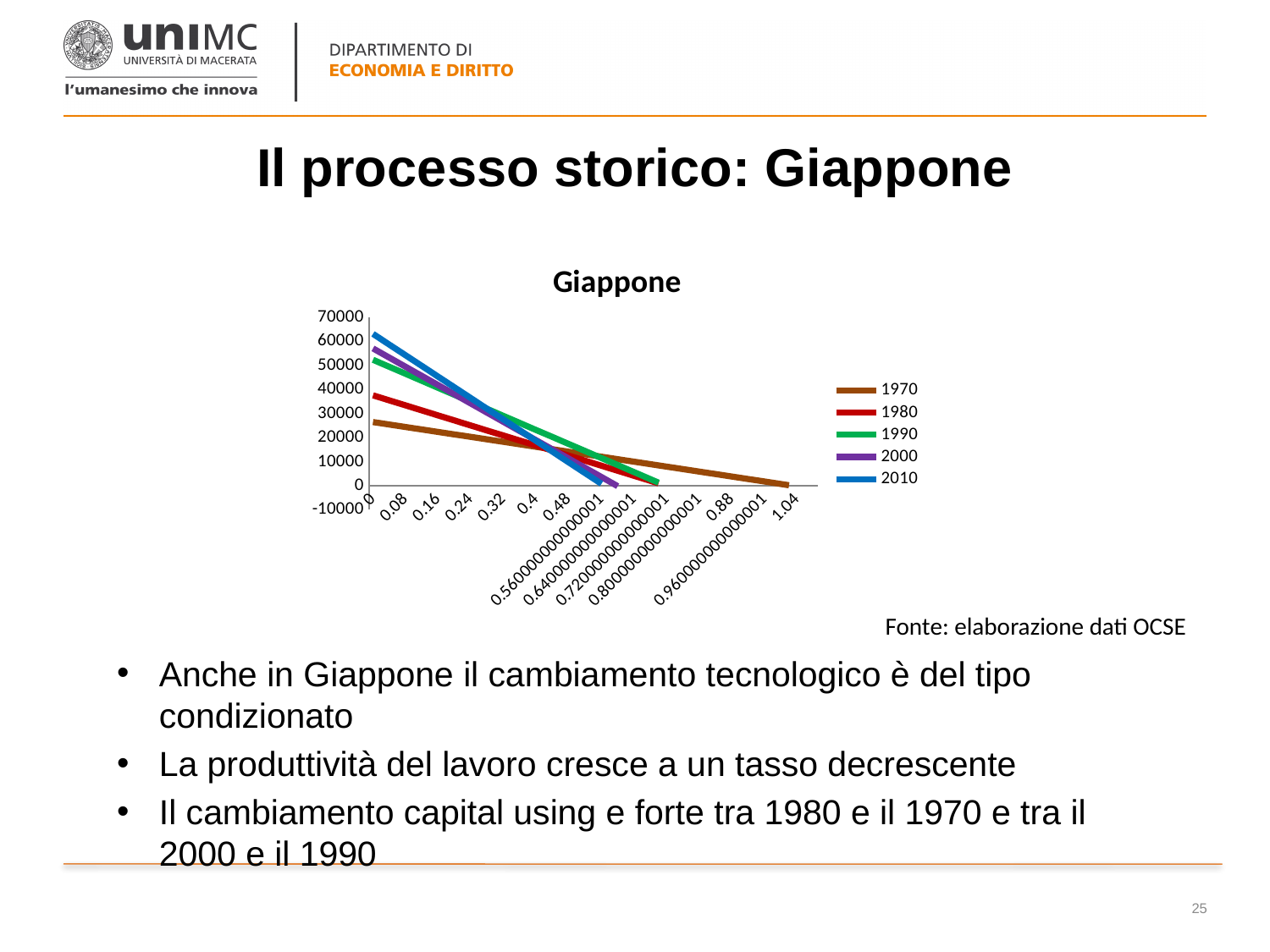
What kind of chart is shown on the slide? line chart Is the value of the 2000 series at x = 0 greater or less than 50000? greater Which series has the highest value at x = 0? 2010 What is the title of the chart? Giappone At x = 0, which series has the larger value, 2010 or 1970? 2010 Which years are listed in the chart's legend? 1970, 1980, 1990, 2000, 2010 At x = 0, which series has the larger value, 1980 or 1990? 1990 Which series reaches zero at the largest x-axis value? 1970 Do the lines in the chart rise or fall as the x-axis value increases? fall How many series does the legend of the chart list? 5 Which series has the lowest value at x = 0? 1970 Is the value of the 1970 series at x = 0 greater or less than 30000? less